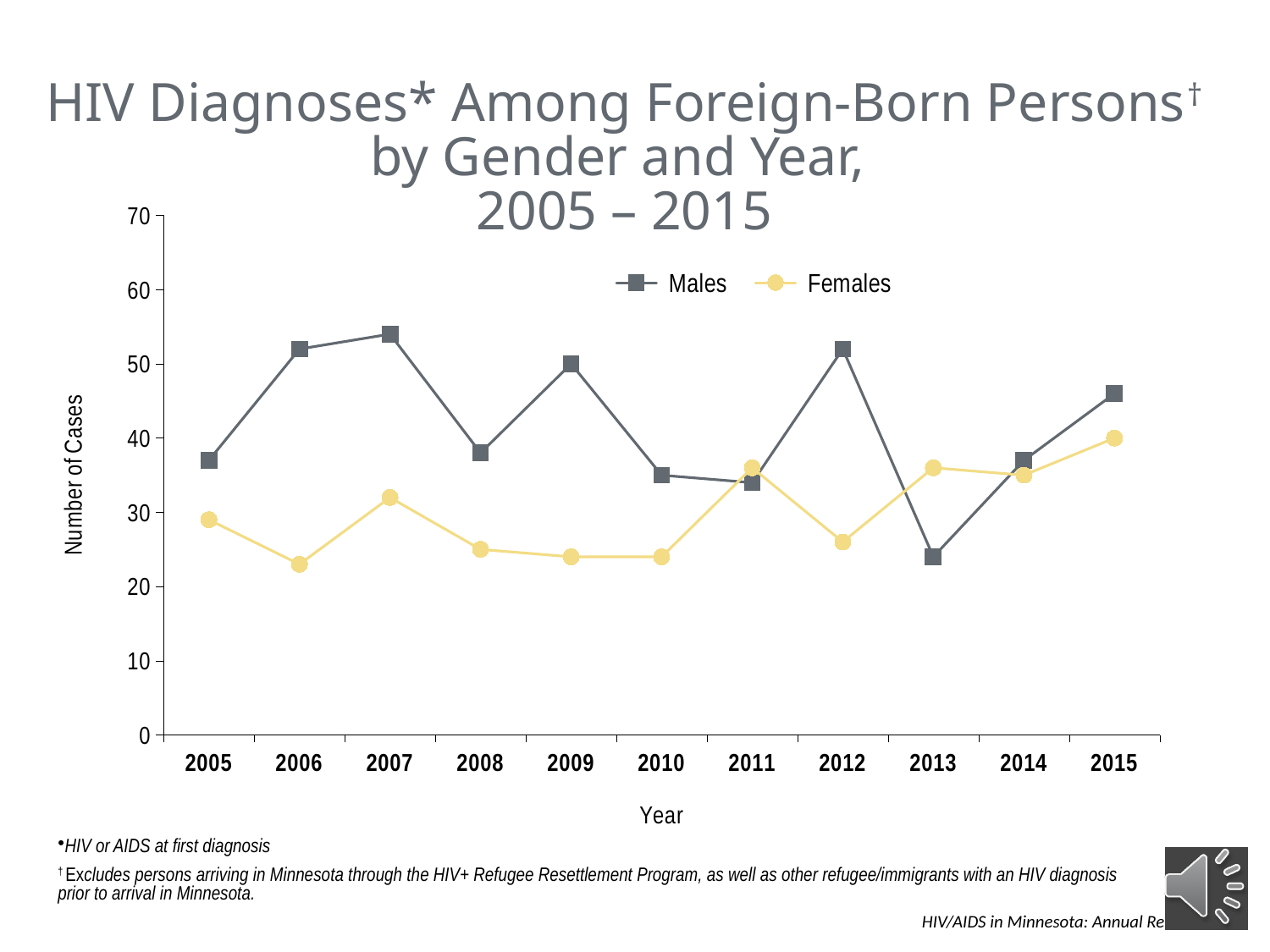
What is the label on the y axis? Number of Cases In which year is the Females value highest? 2015 How many series does the legend list? 2 Is the Males value for 2013 greater or less than 30? less What kind of chart is shown on the slide? line chart In 2013, which series has the larger value, Males or Females? Females In which year is the Males value lowest? 2013 Is the Females value for 2006 greater or less than 30? less Is the Males value for 2009 greater or less than 40? greater In 2012, which series has the larger value, Males or Females? Males How many years are shown along the x axis? 11